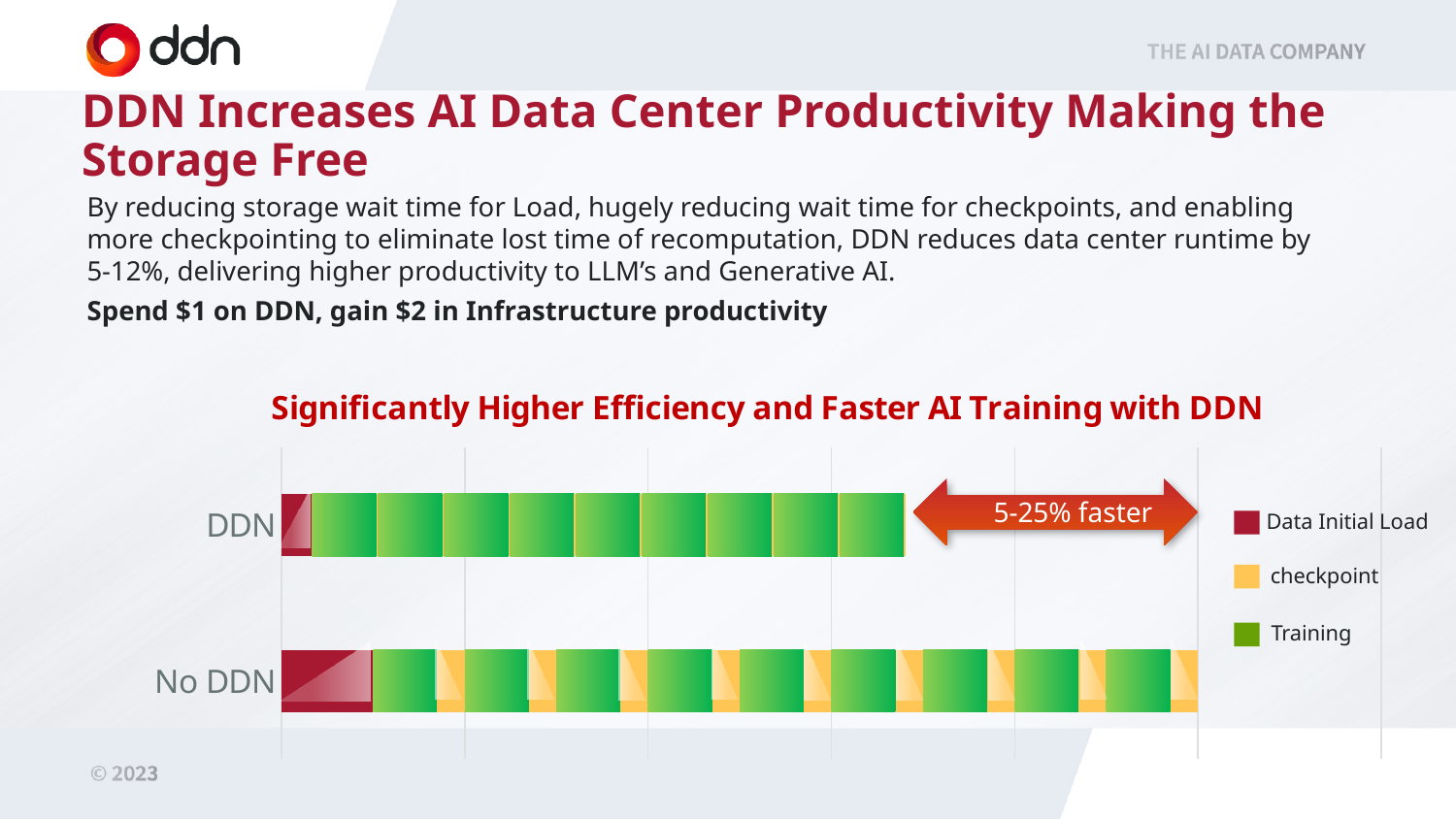
What kind of chart is shown on the slide? Stacked bar chart What are the two categories shown on the chart? DDN and No DDN Which category has the larger Data Initial Load segment, DDN or No DDN? No DDN How many series does the chart's legend list? 3 Which category has the longer total bar, DDN or No DDN? No DDN Which category has the shorter total bar? DDN What does the arrow annotation on the chart say? 5-25% faster How many categories are plotted on the chart's vertical axis? 2 Which series is shown in green in the chart's legend? Training What is the title of the chart? Significantly Higher Efficiency and Faster AI Training with DDN